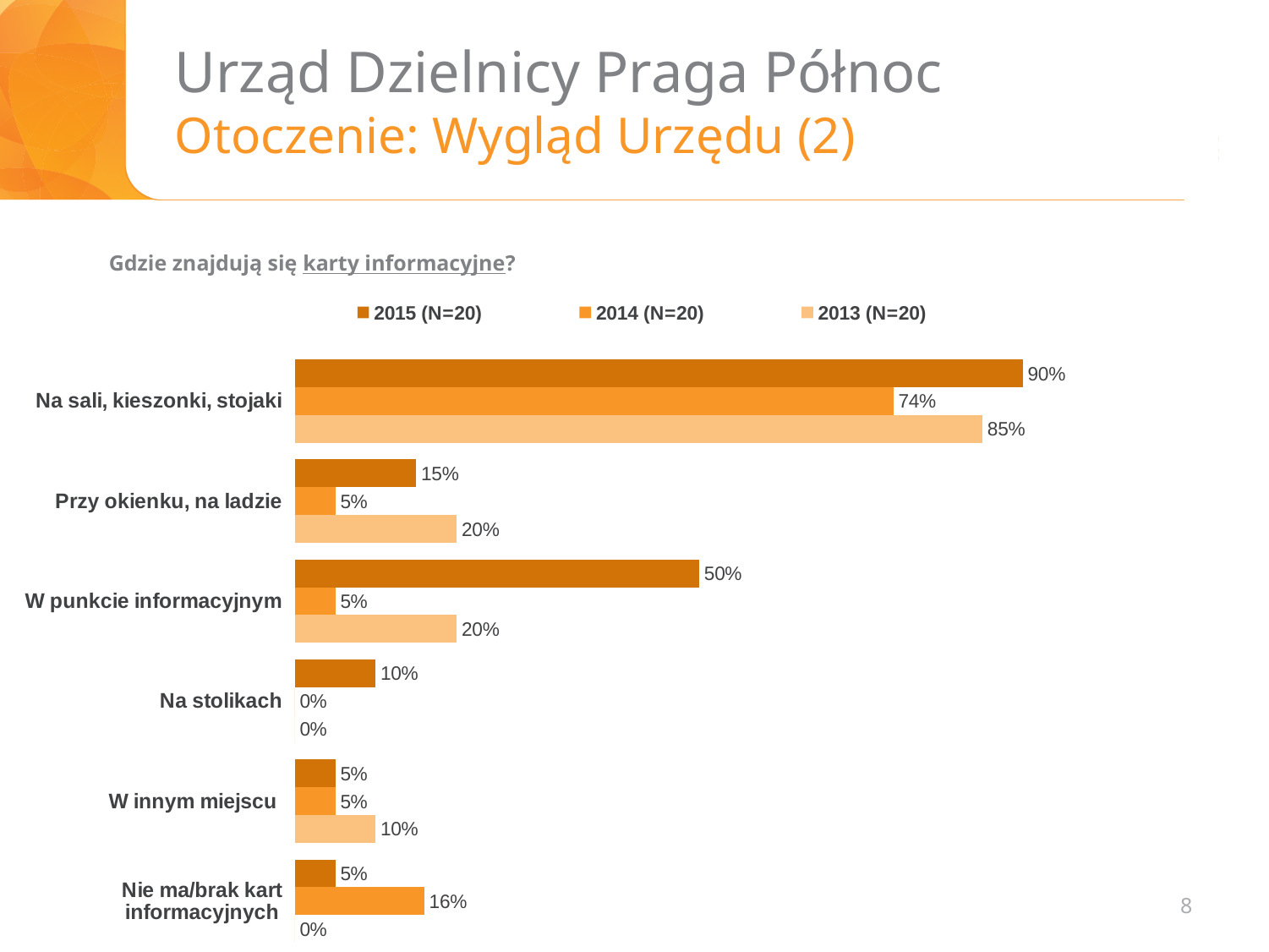
What is the value for "W punkcie informacyjnym" in the 2014 (N=20) series? 5% How many series does the legend list? 3 What kind of chart is shown on the slide? Bar chart What is the value for "Na sali, kieszonki, stojaki" in the 2015 (N=20) series? 90% Which category has the highest value in the 2013 (N=20) series? Na sali, kieszonki, stojaki What is the difference between the 2015 and 2014 values for "W punkcie informacyjnym"? 45% What is the difference between the 2015 and 2013 values for "Na sali, kieszonki, stojaki"? 5% Which category has the lowest value in the 2015 (N=20) series? W innym miejscu and Nie ma/brak kart informacyjnych (both 5%) What is the value for "Nie ma/brak kart informacyjnych" in the 2013 (N=20) series? 0% Which is larger for "Przy okienku, na ladzie": the 2015 value or the 2013 value? 2013 How many categories are shown on the chart? 6 What question does the chart answer, according to the text above it? Gdzie znajdują się karty informacyjne?